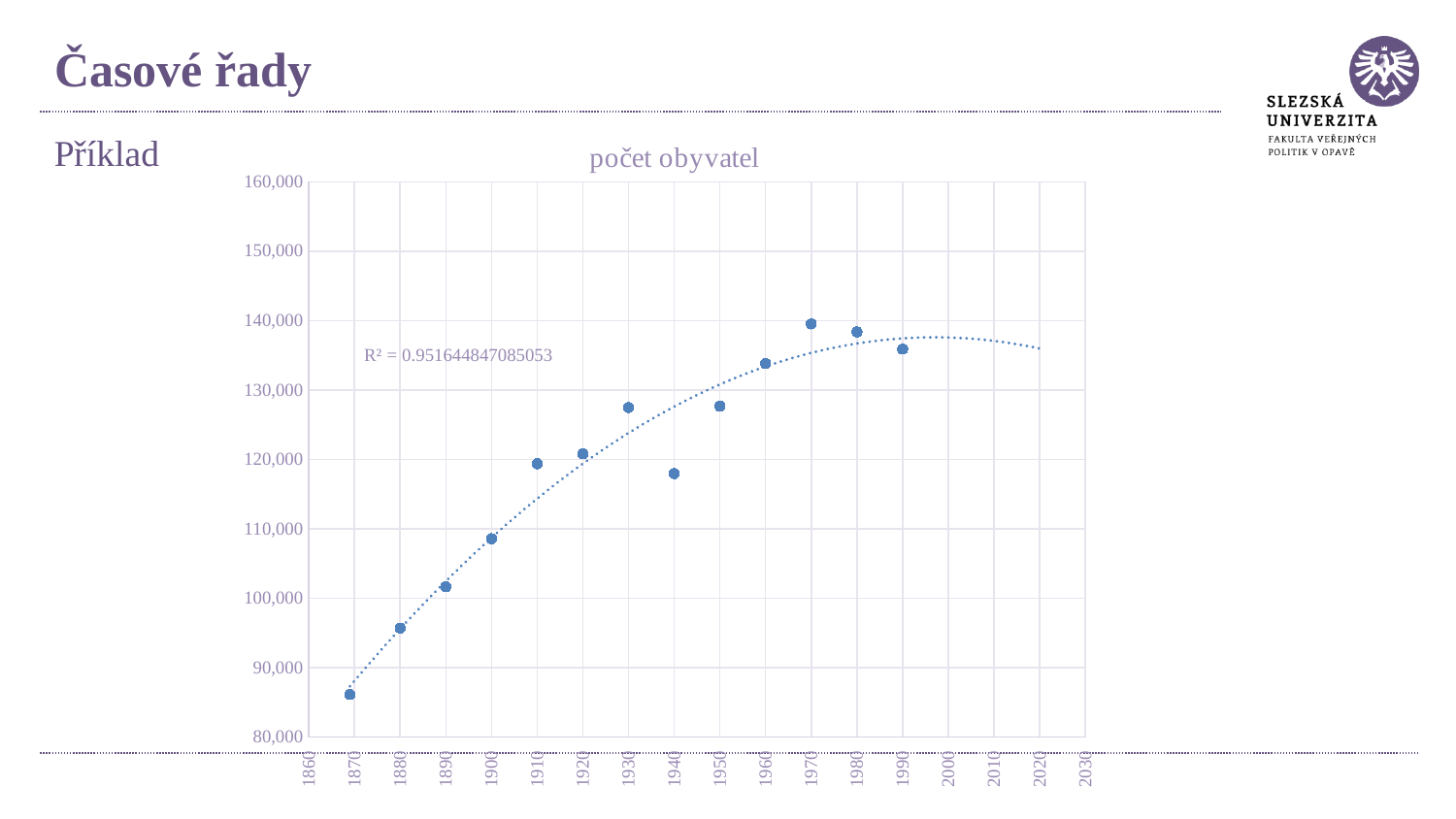
Is the value for the point around 1940 greater or less than 120,000? less Do the plotted values generally rise or fall from the earliest year to around 1970? rise Is the value for the point around 1880 greater or less than 90,000? greater What is the title of the chart? počet obyvatel Is the value for the point around 1970 greater or less than 130,000? greater How many data points are plotted on the chart? 13 What R² value is printed on the chart? R² = 0.951644847085053 Which plotted point has the lowest value? the first point, around 1869 Which is larger, the value for the point around 1940 or the value for the point around 1950? around 1950 What kind of chart is shown on the slide? scatter chart